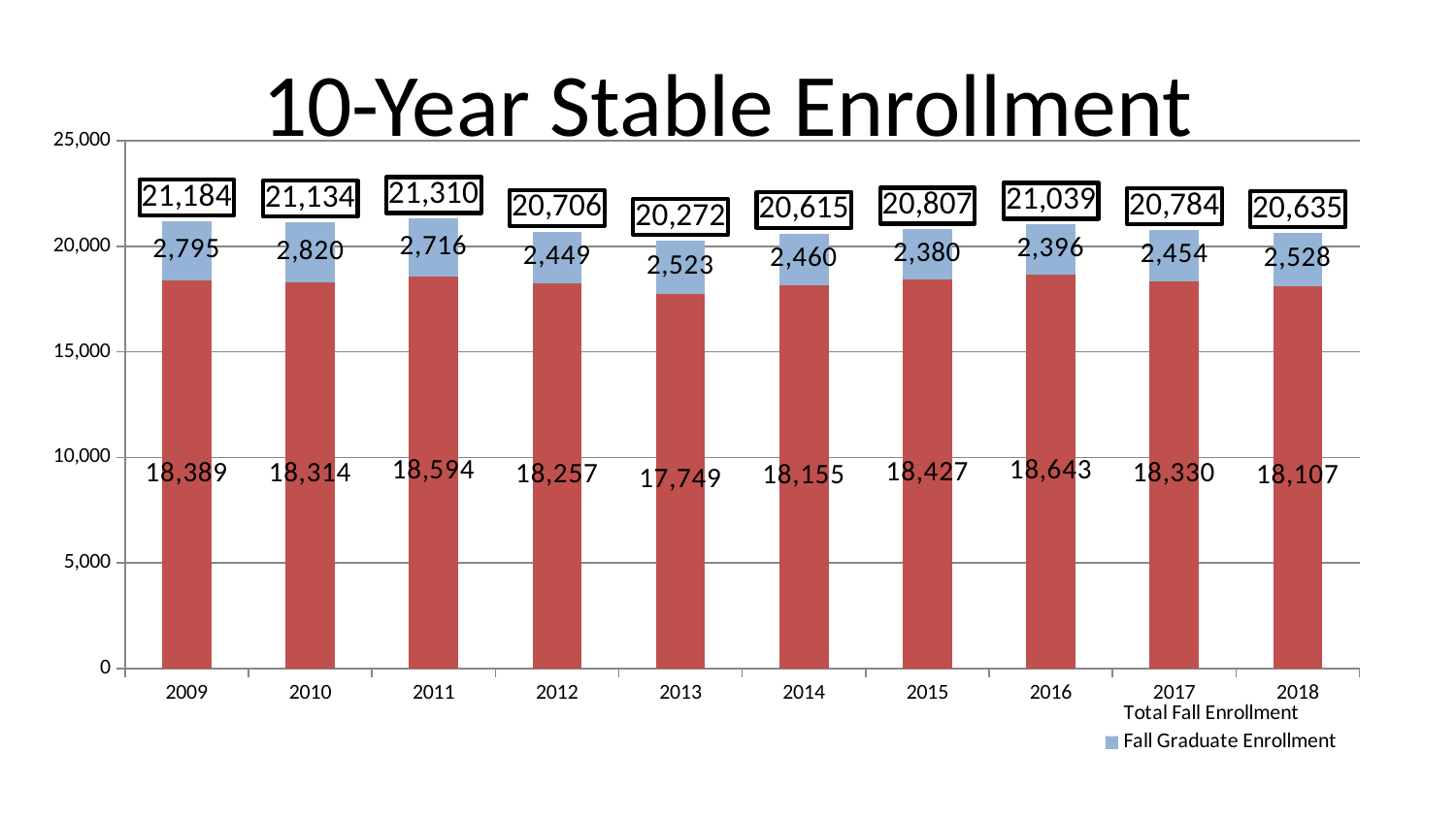
Which year has the lowest total fall enrollment? 2013 What is the Fall Graduate Enrollment value for 2010? 2,820 Which year has the highest total fall enrollment? 2011 What value is printed on the red (lower) segment of the 2013 bar? 17,749 Is the value of the red (lower) segment for 2013 greater or less than 18,000? less What kind of chart is shown on the slide? Stacked bar chart Does the value of the red (lower) segment rise or fall from 2016 to 2018? Fall How many years are shown on the x axis? 10 Is the Fall Graduate Enrollment larger in 2009 or in 2018? 2009 What is the total fall enrollment shown for 2011? 21,310 Which year has the lowest Fall Graduate Enrollment? 2015 What is the difference between the total fall enrollment in 2011 and in 2013? 1,038